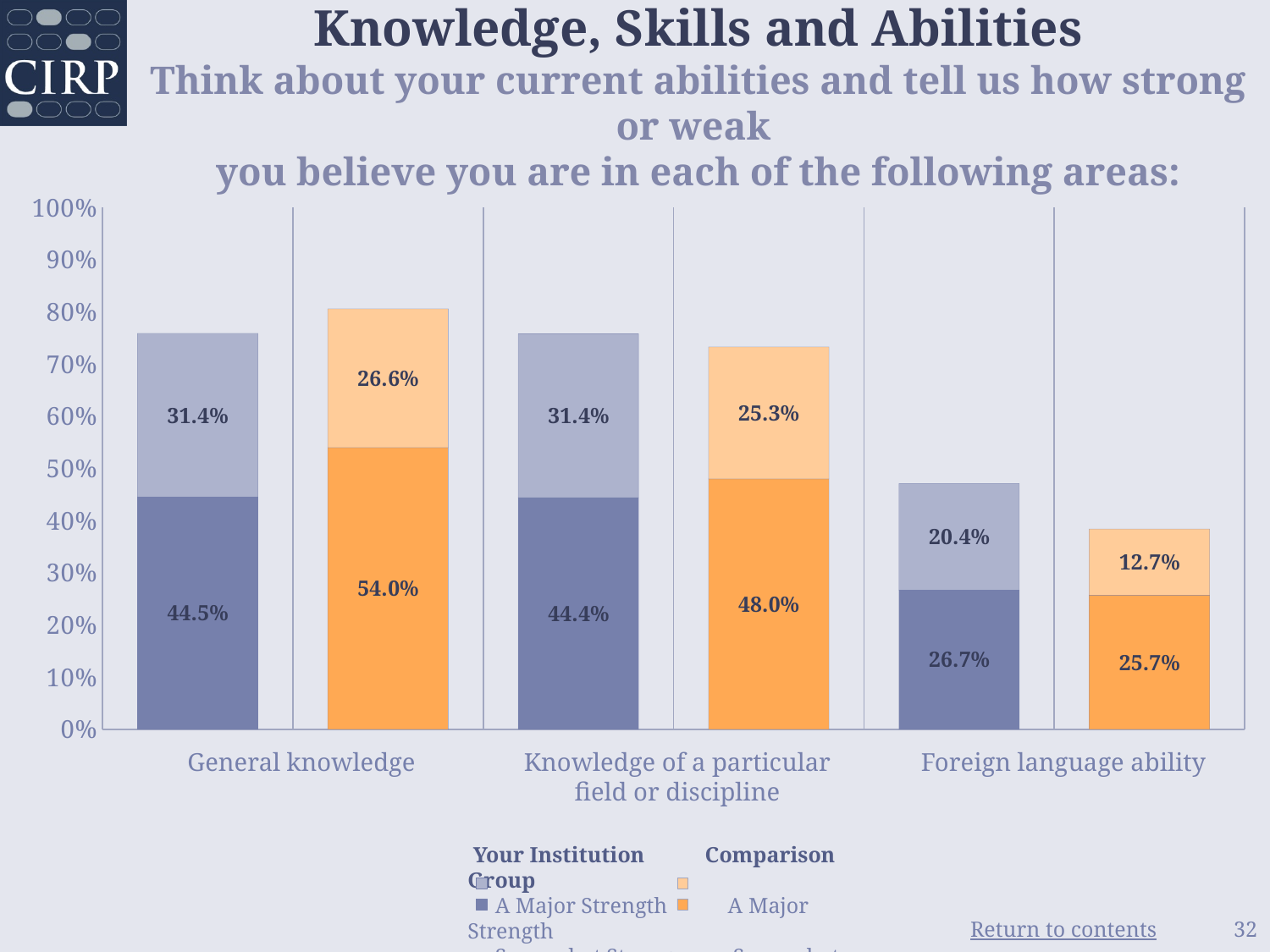
For Foreign language ability, which group has the larger "A Major Strength" percentage, Your Institution or the Comparison Group? Your Institution For General knowledge, how many percentage points higher is the Comparison Group's "A Major Strength" value than Your Institution's? 9.5 percentage points How many ability categories are shown on the x axis of the chart? 3 What percentage of the Comparison Group rated Foreign language ability as "A Major Strength"? 25.7% What is the total height of the Comparison Group stacked bar for Foreign language ability? 38.4% What type of chart is shown on the slide? Stacked bar chart For Your Institution, which category has the lowest "A Major Strength" percentage? Foreign language ability What percentage of students at Your Institution rated General knowledge as "A Major Strength"? 44.5% Is the total of the Your Institution stacked bar for Foreign language ability greater or less than 50%? less For the Comparison Group, which category has the highest "A Major Strength" percentage? General knowledge What value is printed on the upper (lighter) segment of the Comparison Group bar for Knowledge of a particular field or discipline? 25.3% What is the total height of the Your Institution stacked bar for General knowledge? 75.9%